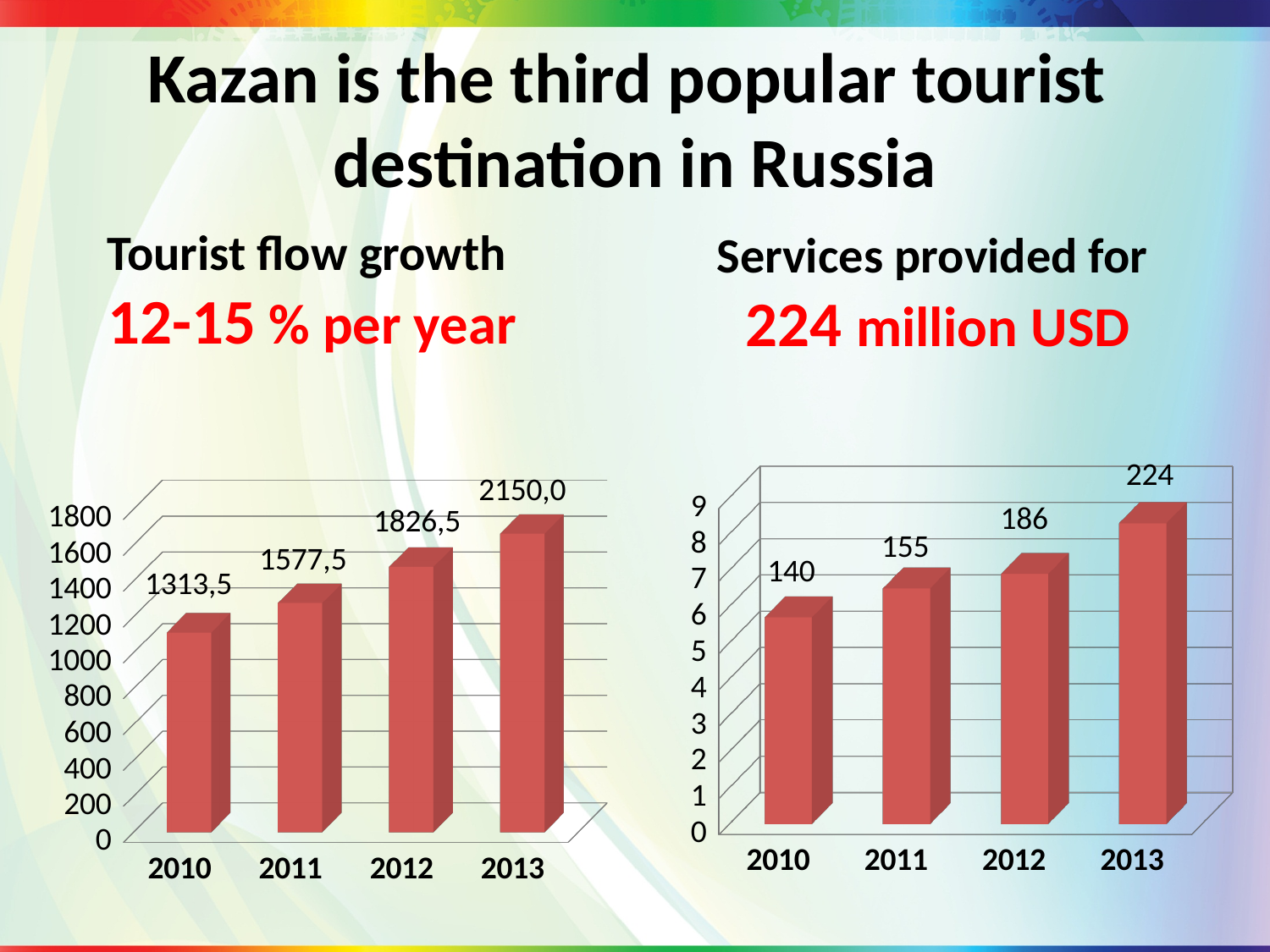
In the right chart, what is the difference between the values for 2013 and 2010? 84 In the left chart, what is the value for 2010? 1313,5 In the right chart, what is the value for 2012? 186 In the right chart, what is the value for 2011? 155 In the right chart, which is larger, the value for 2012 or the value for 2011? 2012 What kind of chart is the right chart? bar chart In the right chart, do the values rise or fall from 2010 to 2013? rise In the left chart, what is the value for 2013? 2150,0 In the right chart, which year has the lowest value? 2010 How many bars does the left chart have? 4 In the left chart, what is the difference between the values for 2012 and 2011? 249,0 In the left chart, which year has the highest value? 2013